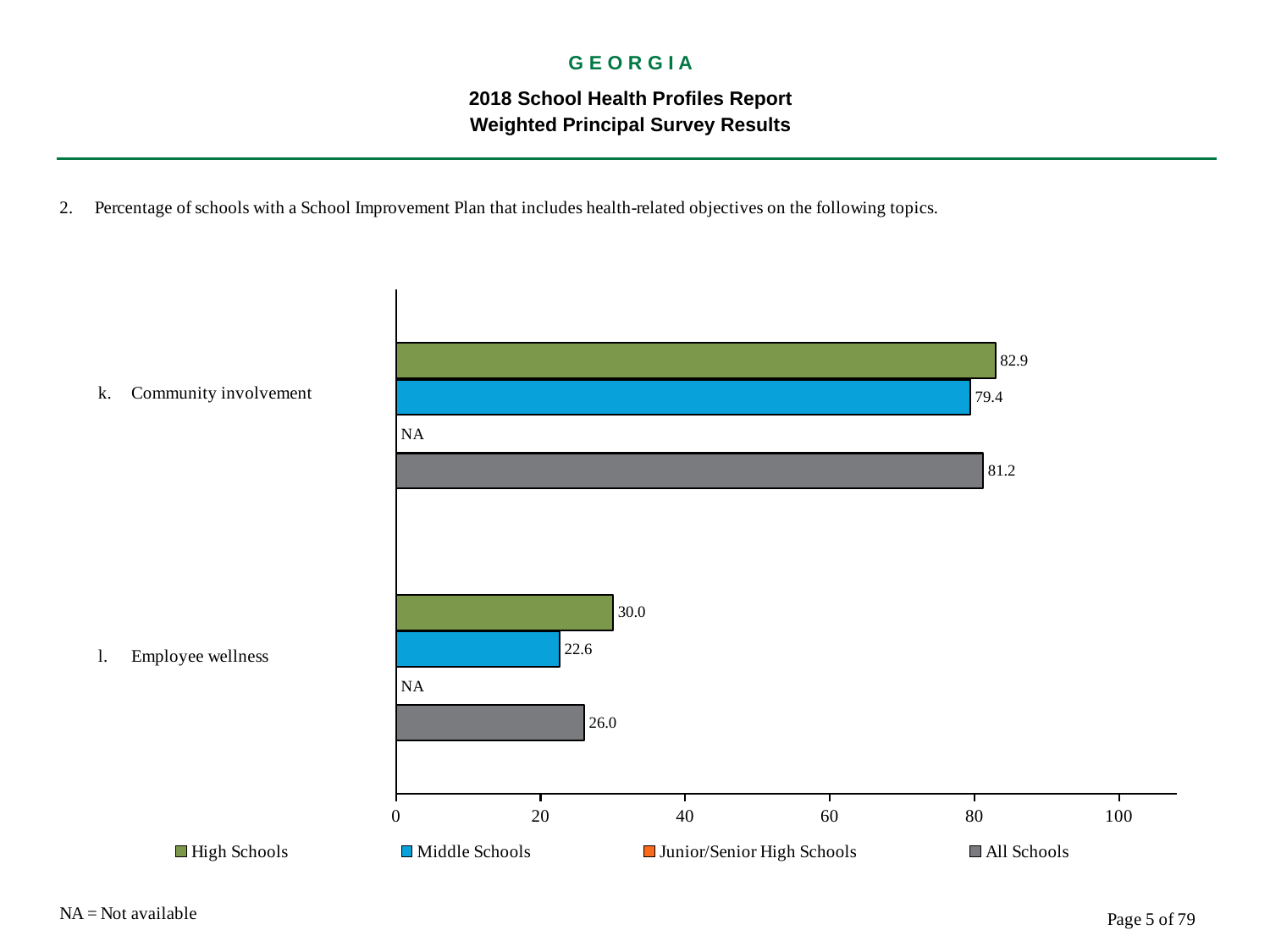
What is the value for Junior/Senior High Schools for Employee wellness? NA What is the difference between the High Schools and Middle Schools values for Employee wellness? 7.4 Which school type has the lowest value for Community involvement among those with a value shown? Middle Schools What is the value for All Schools for Community involvement? 81.2 What kind of chart is shown on the slide? bar chart Is the All Schools value for Employee wellness greater or less than 40? less What is the value for Middle Schools for Employee wellness? 22.6 What is the value for High Schools for Community involvement? 82.9 How many topics are shown on the chart? 2 How many series does the legend list? 4 Which is larger for Community involvement: the High Schools value or the All Schools value? High Schools Which school type has the highest value for Employee wellness? High Schools